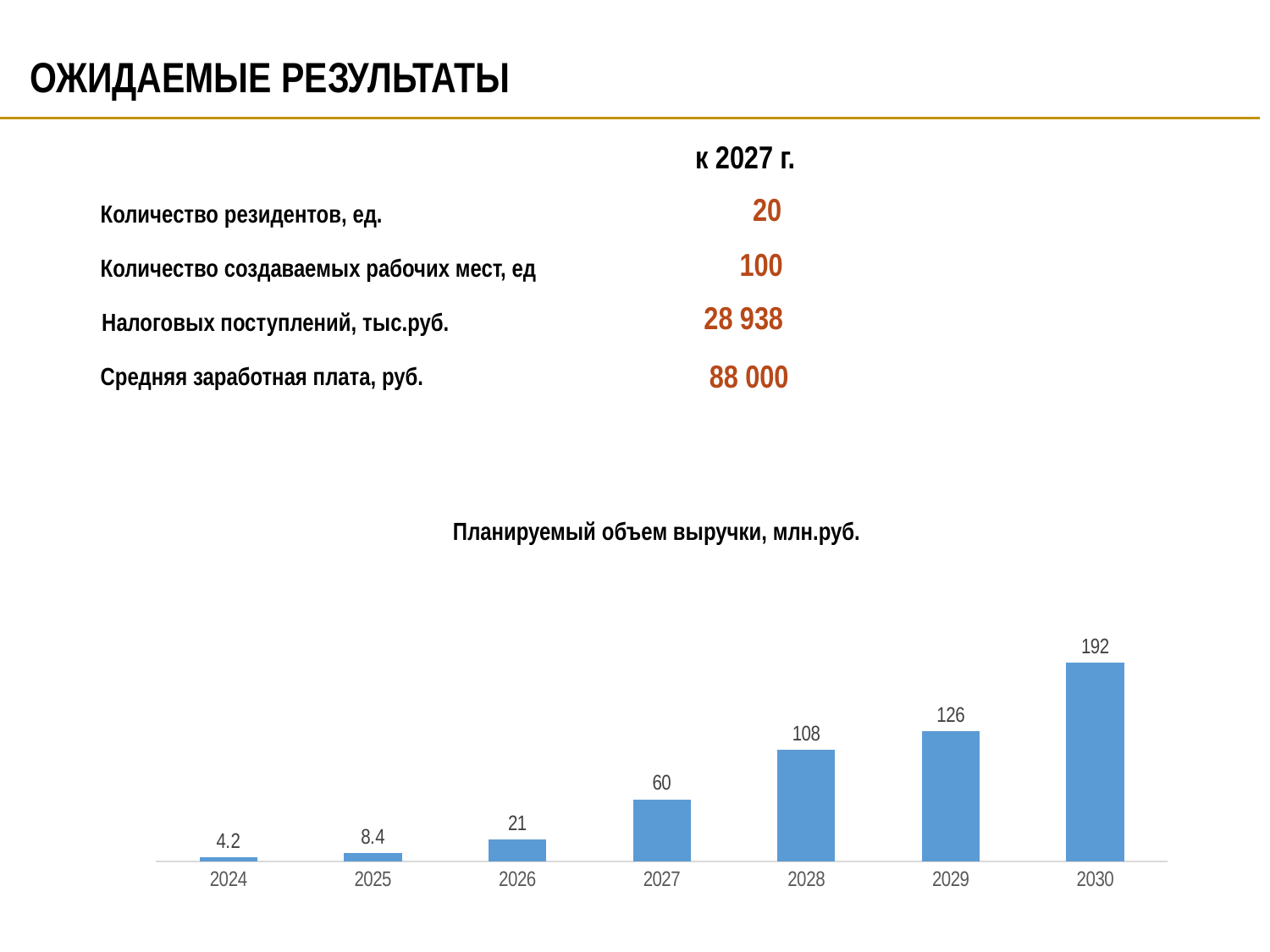
What is the difference in planned revenue between 2030 and 2029? 66 What is the planned revenue for 2029? 126 Which year has the lowest planned revenue? 2024 Which year has the highest planned revenue? 2030 What is the planned revenue for 2027 in the chart 'Планируемый объем выручки, млн.руб.'? 60 What is the difference in planned revenue between 2028 and 2027? 48 Which year has a larger planned revenue, 2026 or 2028? 2028 How many years are shown on the x axis of the chart? 7 What is the planned revenue for 2030? 192 What type of chart is used to show the planned revenue? Bar chart Do the planned revenue values rise or fall from 2024 to 2030? Rise What is the planned revenue for 2024? 4.2